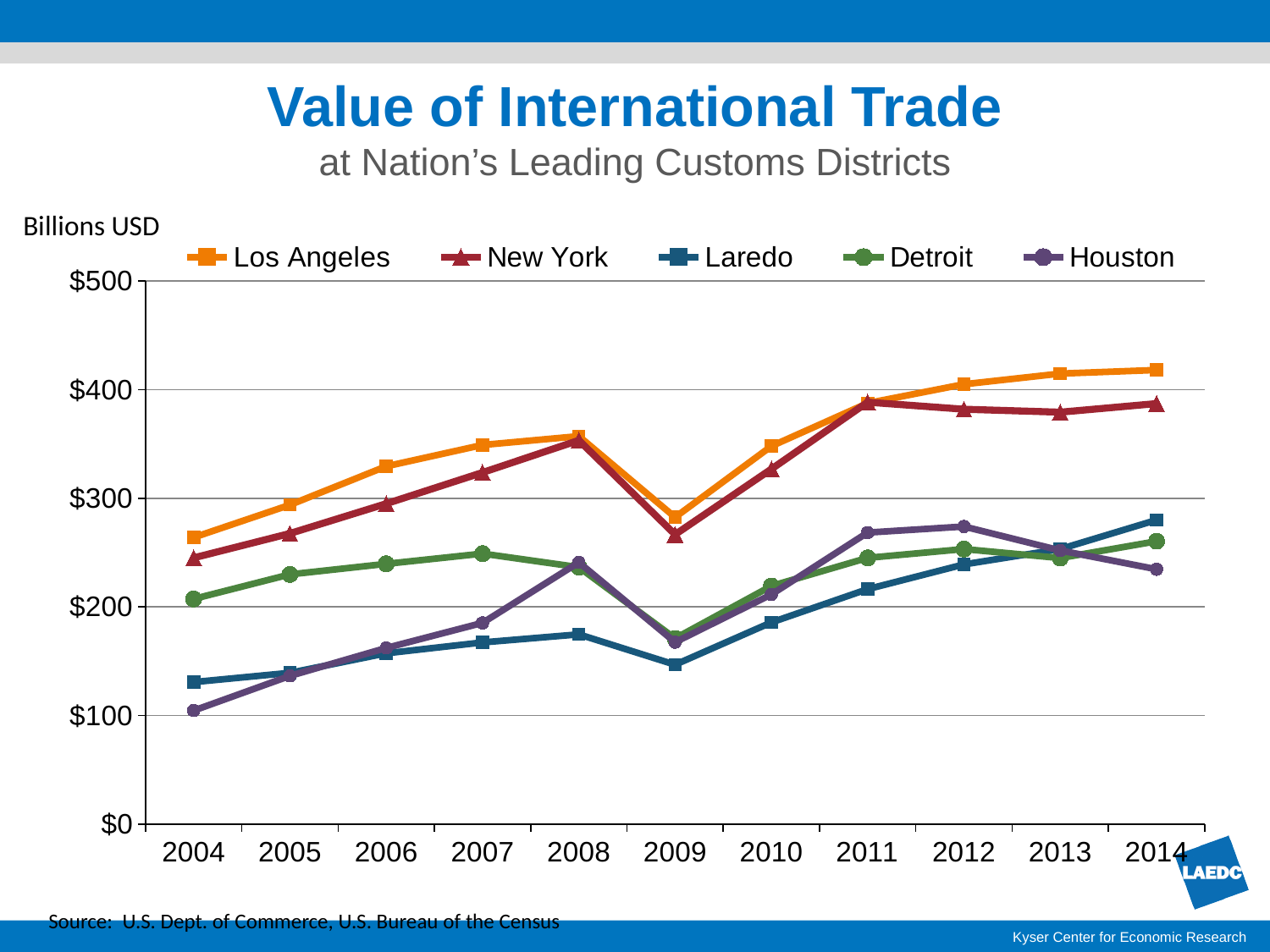
Which customs district has the highest value in 2014? Los Angeles Does the value for Los Angeles rise or fall from 2009 to 2014? rise Is the value for Houston in 2004 greater or less than $200? less Is the value for New York in 2009 greater or less than $300? less Which customs district has the lowest value in 2004? Houston What kind of chart is shown on the slide? line chart What unit is given for the y axis of the chart? Billions USD How many years are shown along the x axis? 11 How many series does the legend list? 5 In 2011, which is larger, the value for Houston or the value for Detroit? Houston In 2014, which is larger, the value for Laredo or the value for Houston? Laredo Is the value for Los Angeles in 2014 greater or less than $400? greater